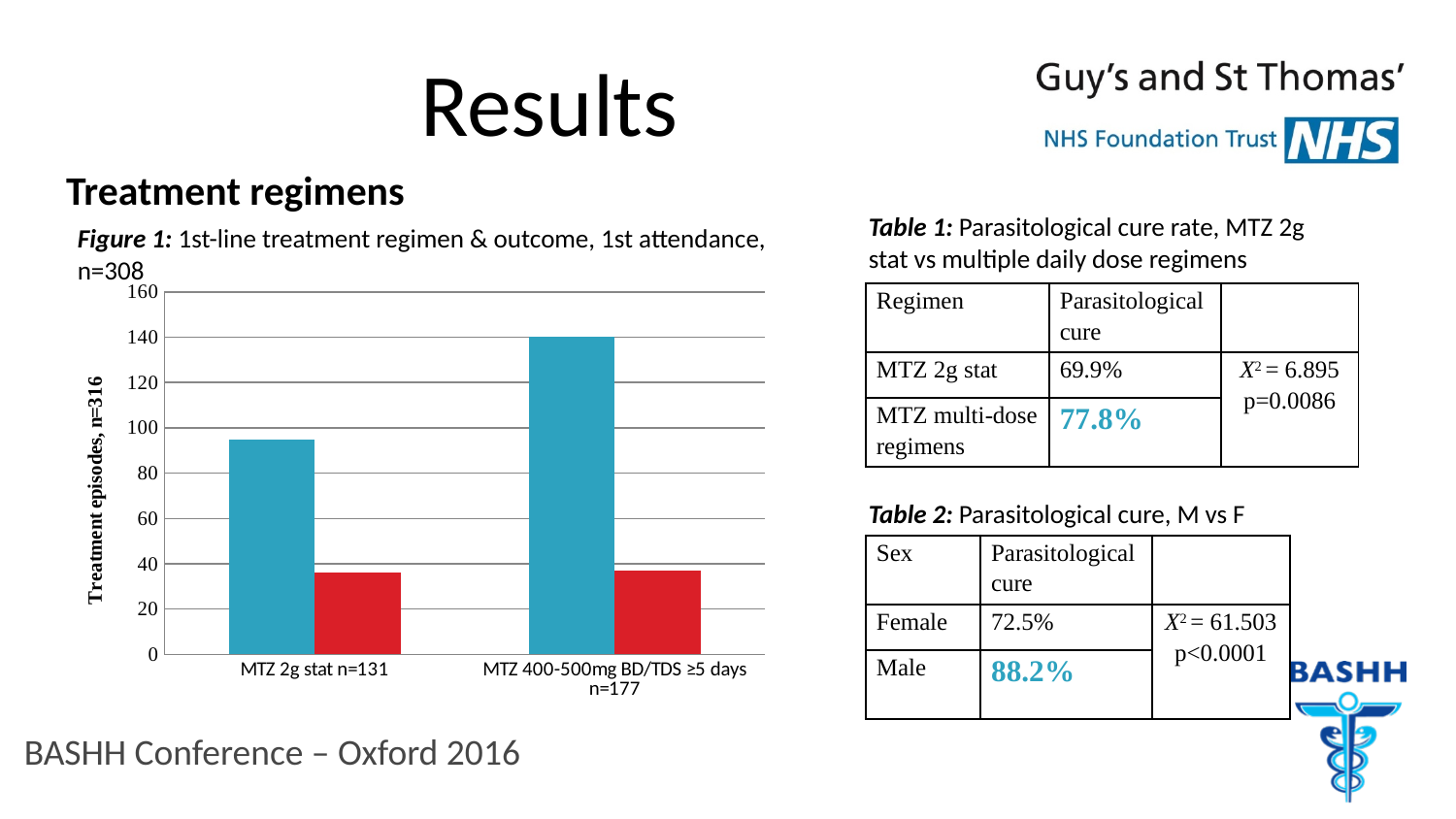
In the bar chart, which is larger for MTZ 2g stat n=131: the blue bar or the red bar? the blue bar How many treatment regimen categories are shown on the x axis of the bar chart? 2 In the bar chart, is the blue bar for MTZ 2g stat n=131 greater or less than 100? less In the bar chart, is the blue bar for MTZ 400-500mg BD/TDS ≥5 days n=177 greater or less than 120? greater What is the caption of Figure 1 on the slide? 1st-line treatment regimen & outcome, 1st attendance, n=308 In the bar chart, is the blue bar for MTZ 2g stat n=131 greater or less than 80? greater Which category has the taller blue bar in the bar chart? MTZ 400-500mg BD/TDS ≥5 days n=177 What is the highest value shown on the y axis of the bar chart? 160 What kind of chart is Figure 1 on the slide? bar chart What is the y-axis title of the bar chart? Treatment episodes, n=316